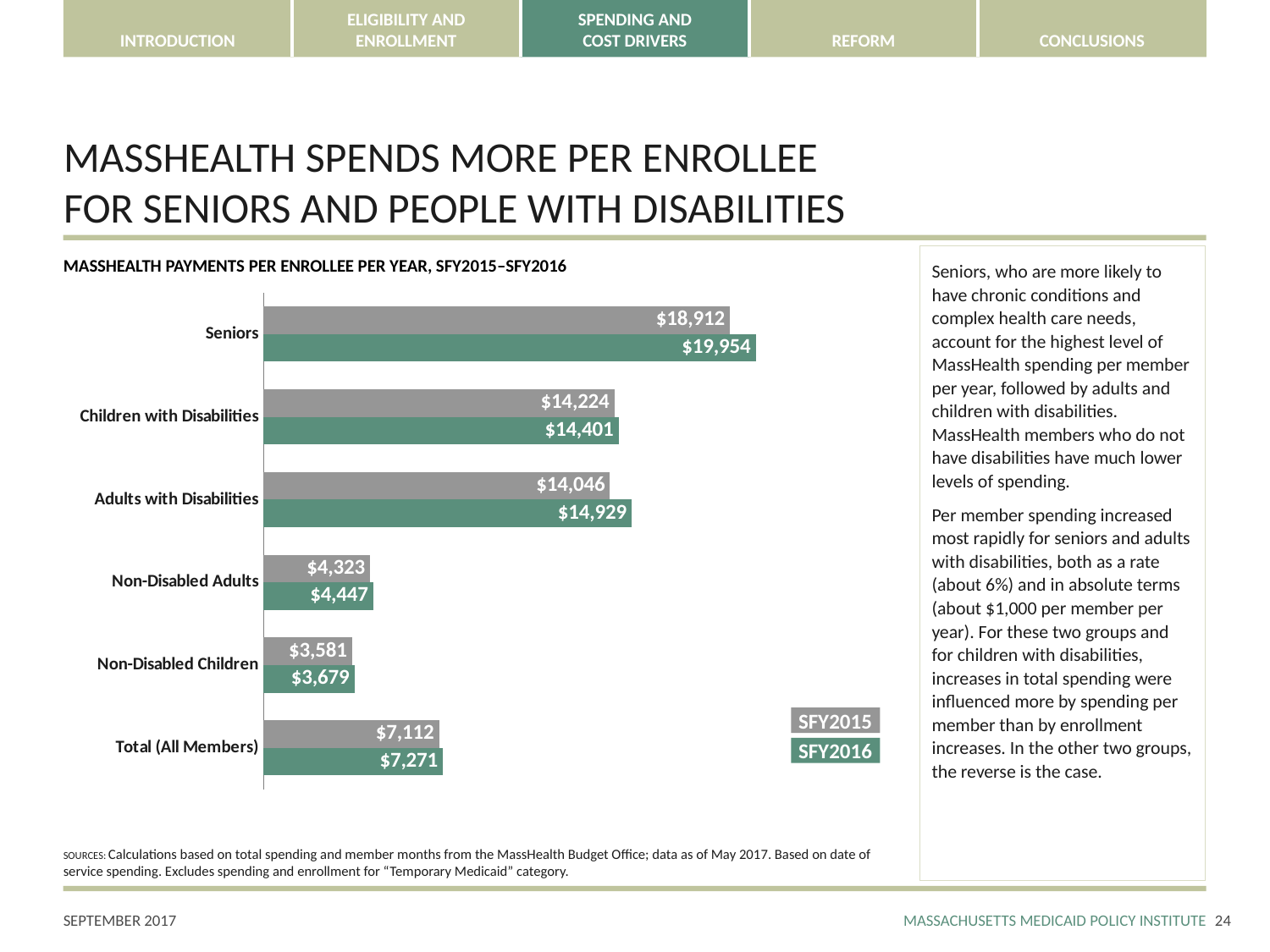
What was the MassHealth payment per enrollee per year for Non-Disabled Children in SFY2015? $3,581 Which was larger in SFY2016: the payment per enrollee for Non-Disabled Adults or for Non-Disabled Children? Non-Disabled Adults Which category had the lowest payment per enrollee in SFY2015? Non-Disabled Children Which category had the highest payment per enrollee in SFY2016? Seniors What is the title of the chart? MASSHEALTH PAYMENTS PER ENROLLEE PER YEAR, SFY2015–SFY2016 What is the difference between the SFY2015 payments per enrollee for Children with Disabilities and Adults with Disabilities? $178 What was the SFY2016 payment per enrollee for Adults with Disabilities? $14,929 What is the difference between the SFY2016 and SFY2015 payments per enrollee for Seniors? $1,042 What kind of chart is shown on the slide? Bar chart What was the MassHealth payment per enrollee per year for Seniors in SFY2016? $19,954 How many series does the legend list? 2 How many categories are shown on the chart? 6